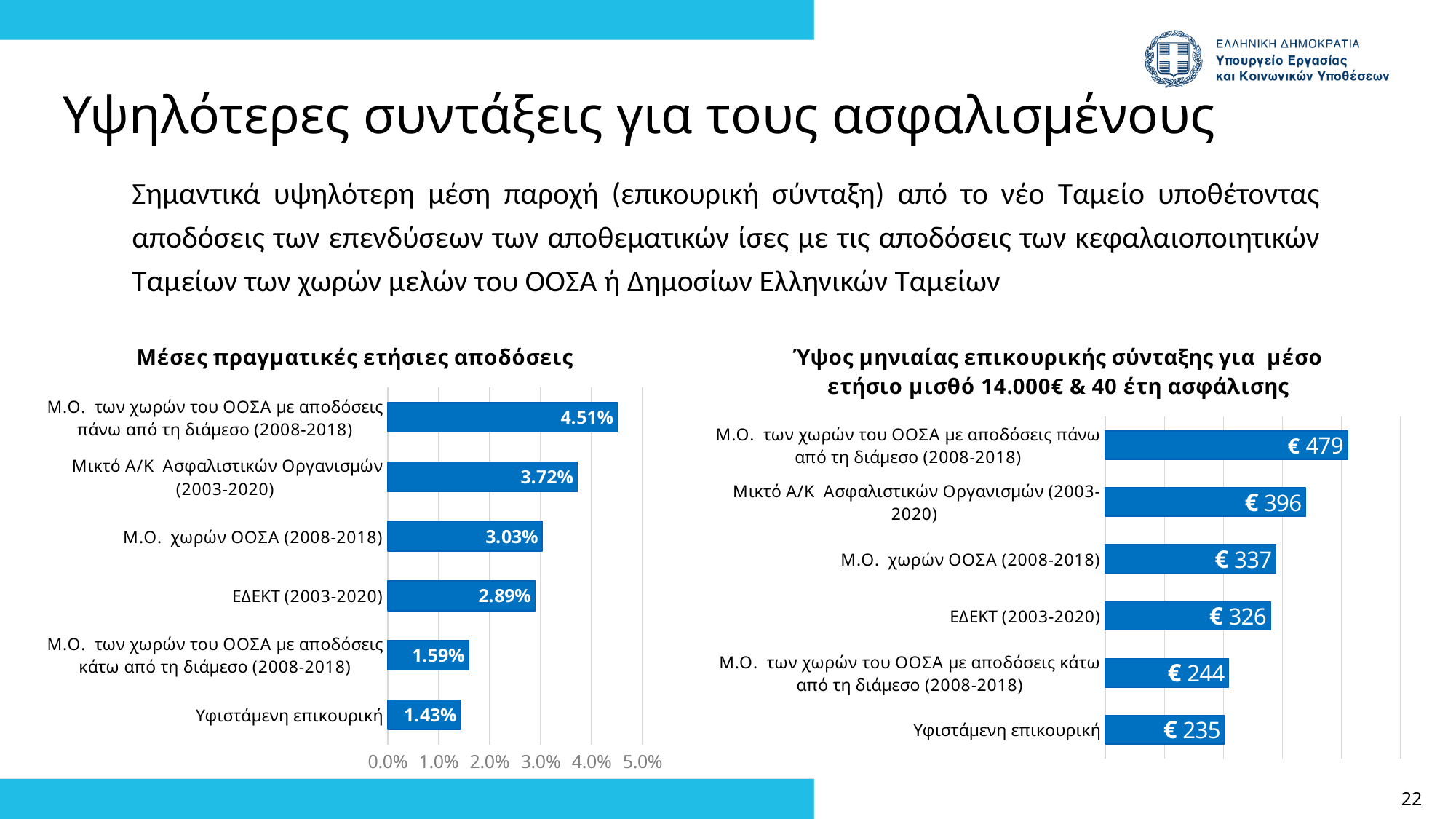
What type of chart is the right chart (Ύψος μηνιαίας επικουρικής σύνταξης)? Bar chart In the right chart (Ύψος μηνιαίας επικουρικής σύνταξης), what is the value for Μ.Ο. των χωρών του ΟΟΣΑ με αποδόσεις κάτω από τη διάμεσο (2008-2018)? € 244 In the right chart (Ύψος μηνιαίας επικουρικής σύνταξης), what is the value for Μ.Ο. χωρών ΟΟΣΑ (2008-2018)? € 337 In the left chart (Μέσες πραγματικές ετήσιες αποδόσεις), what is the difference between Μικτό Α/Κ Ασφαλιστικών Οργανισμών (2003-2020) and Μ.Ο. χωρών ΟΟΣΑ (2008-2018)? 0.69% In the left chart (Μέσες πραγματικές ετήσιες αποδόσεις), which category has the highest value? Μ.Ο. των χωρών του ΟΟΣΑ με αποδόσεις πάνω από τη διάμεσο (2008-2018) In the left chart (Μέσες πραγματικές ετήσιες αποδόσεις), what is the value for Υφιστάμενη επικουρική? 1.43% In the right chart (Ύψος μηνιαίας επικουρικής σύνταξης), which is larger: Μικτό Α/Κ Ασφαλιστικών Οργανισμών (2003-2020) or ΕΔΕΚΤ (2003-2020)? Μικτό Α/Κ Ασφαλιστικών Οργανισμών (2003-2020) In the left chart (Μέσες πραγματικές ετήσιες αποδόσεις), how many categories are shown? 6 In the left chart (Μέσες πραγματικές ετήσιες αποδόσεις), what is the highest value shown on the x axis? 5.0% In the right chart (Ύψος μηνιαίας επικουρικής σύνταξης), which category has the lowest value? Υφιστάμενη επικουρική In the left chart (Μέσες πραγματικές ετήσιες αποδόσεις), what is the value for ΕΔΕΚΤ (2003-2020)? 2.89% In the right chart (Ύψος μηνιαίας επικουρικής σύνταξης), what is the difference between the highest value and the value for Υφιστάμενη επικουρική? € 244